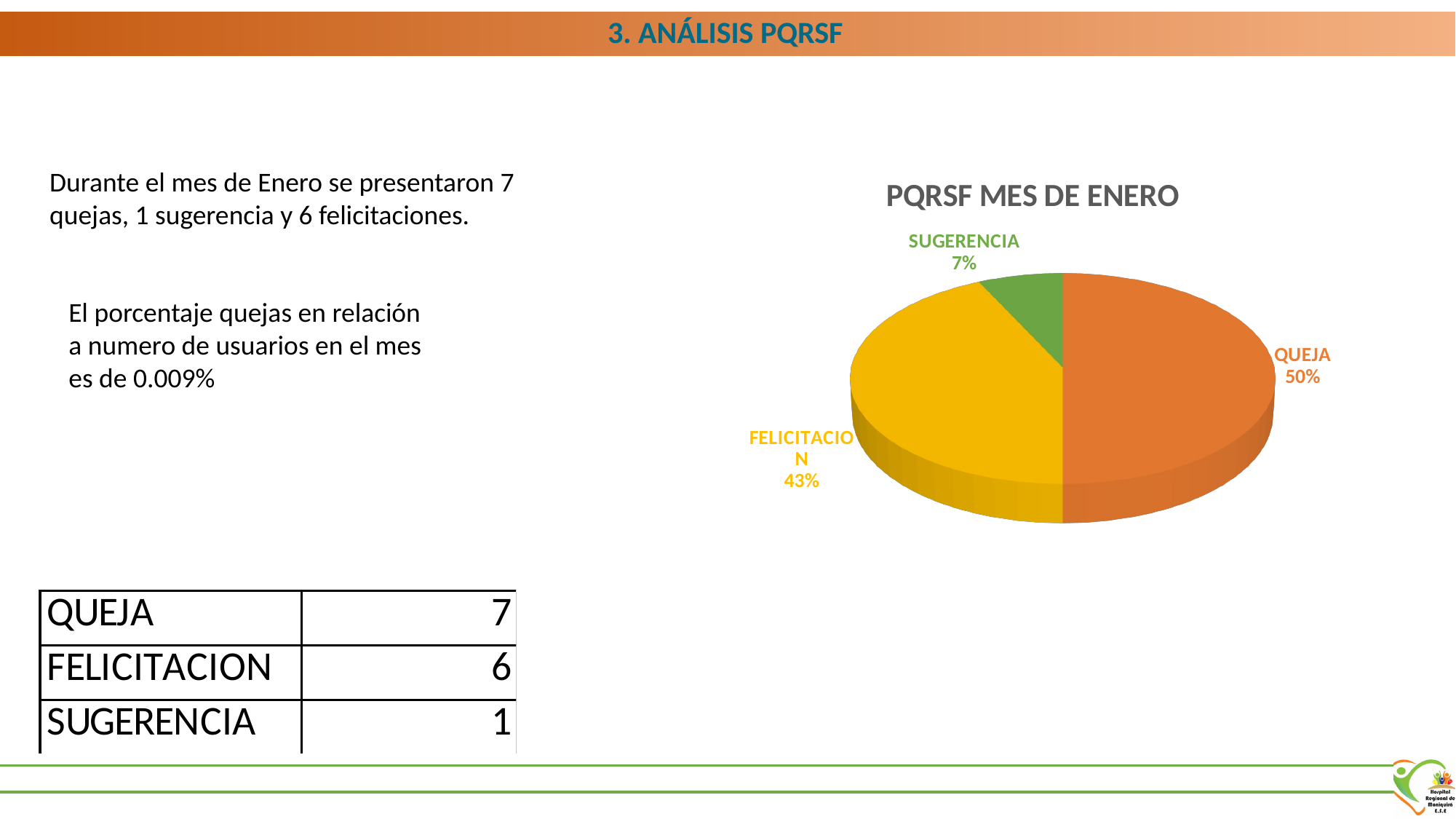
What share of the pie does SUGERENCIA represent? 7% What share of the pie does FELICITACION represent? 43% What share of the pie does QUEJA represent? 50% How many slices does the pie chart have? 3 What is the title of the chart? PQRSF MES DE ENERO What is the difference in percentage points between the QUEJA and FELICITACION slices? 7% What is the difference in percentage points between the FELICITACION and SUGERENCIA slices? 36% What colour is the QUEJA slice? Orange Which category has the largest slice of the pie? QUEJA What type of chart is shown on the slide? Pie chart Which slice is larger, FELICITACION or SUGERENCIA? FELICITACION Which category has the smallest slice of the pie? SUGERENCIA